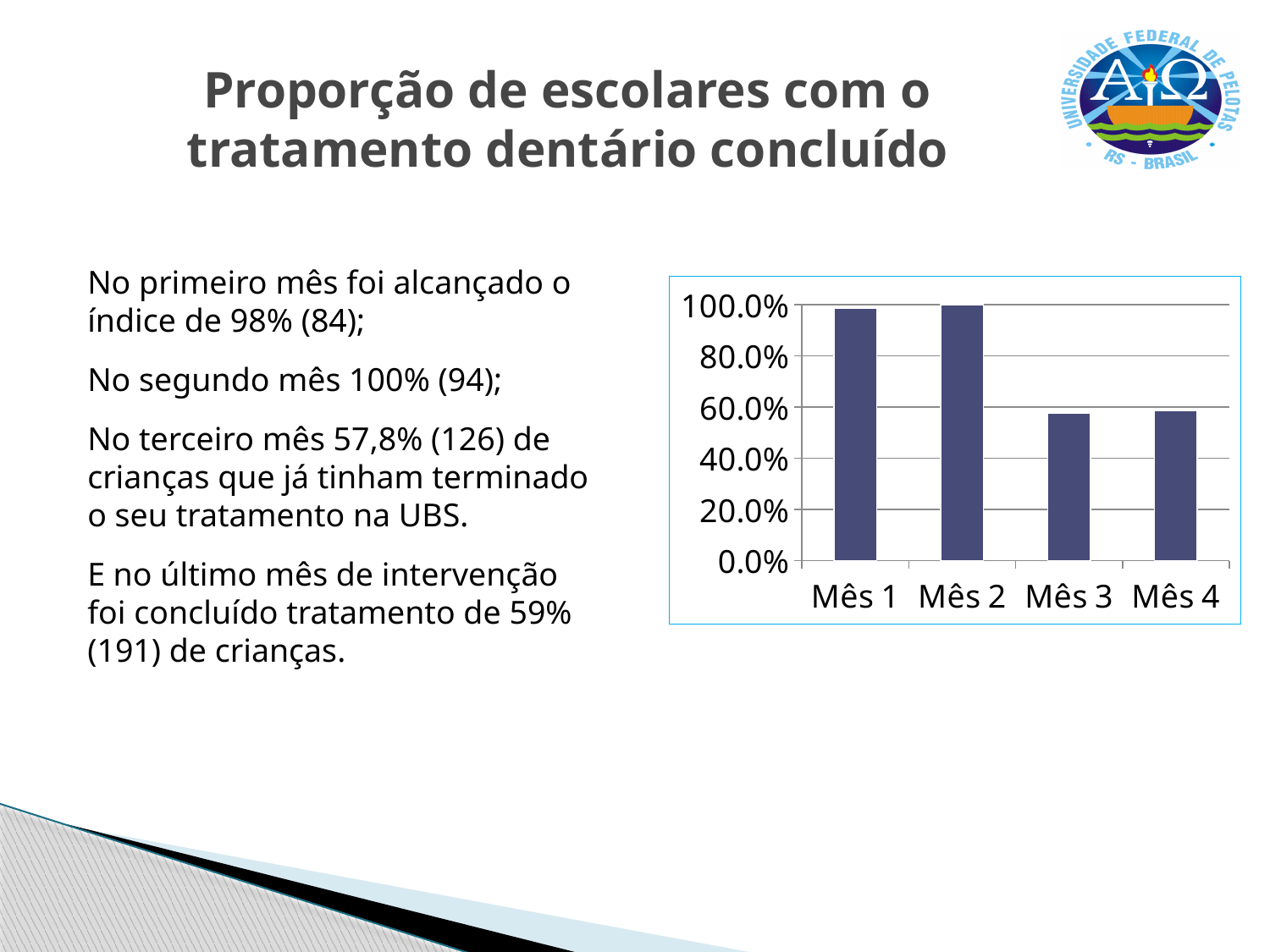
Is the value for Mês 1 greater or less than 80.0%? greater How many categories (months) are shown on the x axis of the chart? 4 Which is larger, the value for Mês 1 or the value for Mês 3? Mês 1 Are the values for Mês 3 and Mês 4 higher or lower than the values for Mês 1 and Mês 2? lower Is the value for Mês 4 greater or less than 40.0%? greater What is the highest tick value shown on the y axis of the chart? 100.0% What kind of chart is shown on the slide? bar chart Is the value for Mês 3 greater or less than 60.0%? less What is the title of the slide containing the chart? Proporção de escolares com o tratamento dentário concluído Which is larger, the value for Mês 4 or the value for Mês 2? Mês 2